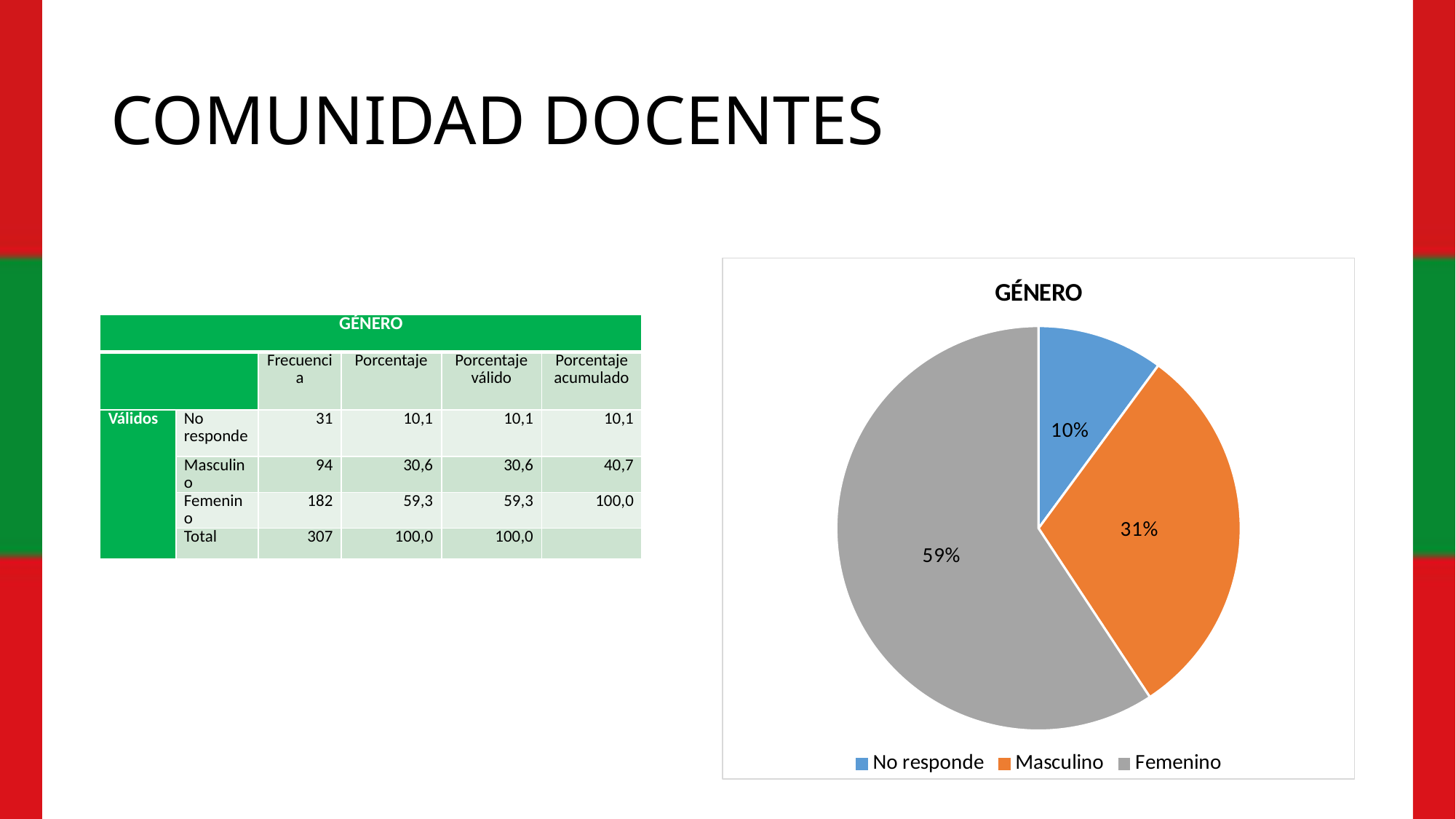
What percentage does the Masculino slice show in the pie chart? 31% How many slices does the pie chart have? 3 What percentage does the Femenino slice show in the pie chart? 59% What is the difference in percentage points between the Femenino and Masculino slices? 28 What type of chart is shown on the slide? pie chart What percentage does the No responde slice show in the pie chart? 10% What colour is the Femenino slice in the pie chart? grey Which is larger in the pie chart, Masculino or No responde? Masculino What is the title of the chart? GÉNERO Which category has the smallest slice in the pie chart? No responde Which category has the largest slice in the pie chart? Femenino How many entries does the legend of the pie chart list? 3